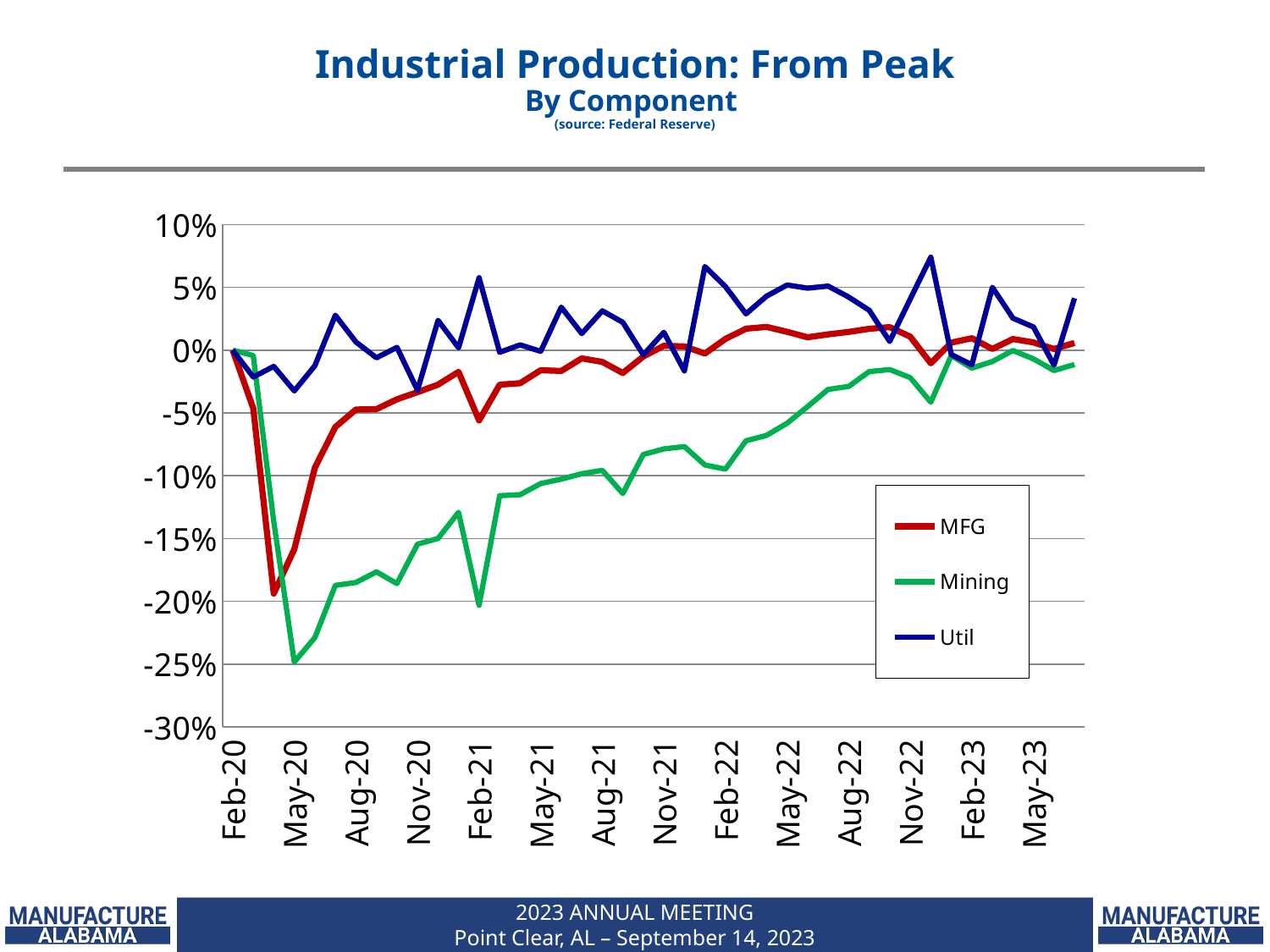
How many series does the legend list? 3 Is the value for Mining at Feb-21 greater or less than -15%? less Which series are listed in the legend? MFG, Mining, Util Which series reaches the highest value on the chart? Util At May-20, which is higher, MFG or Mining? MFG Is the value for Mining at May-20 greater or less than -20%? less What kind of chart is shown on the slide? line chart Which series reaches the lowest value on the chart? Mining What colour is the Mining line? green Is the value for Mining at Aug-22 greater or less than -5%? greater Does the Mining line generally rise or fall from May-20 to May-23? rise